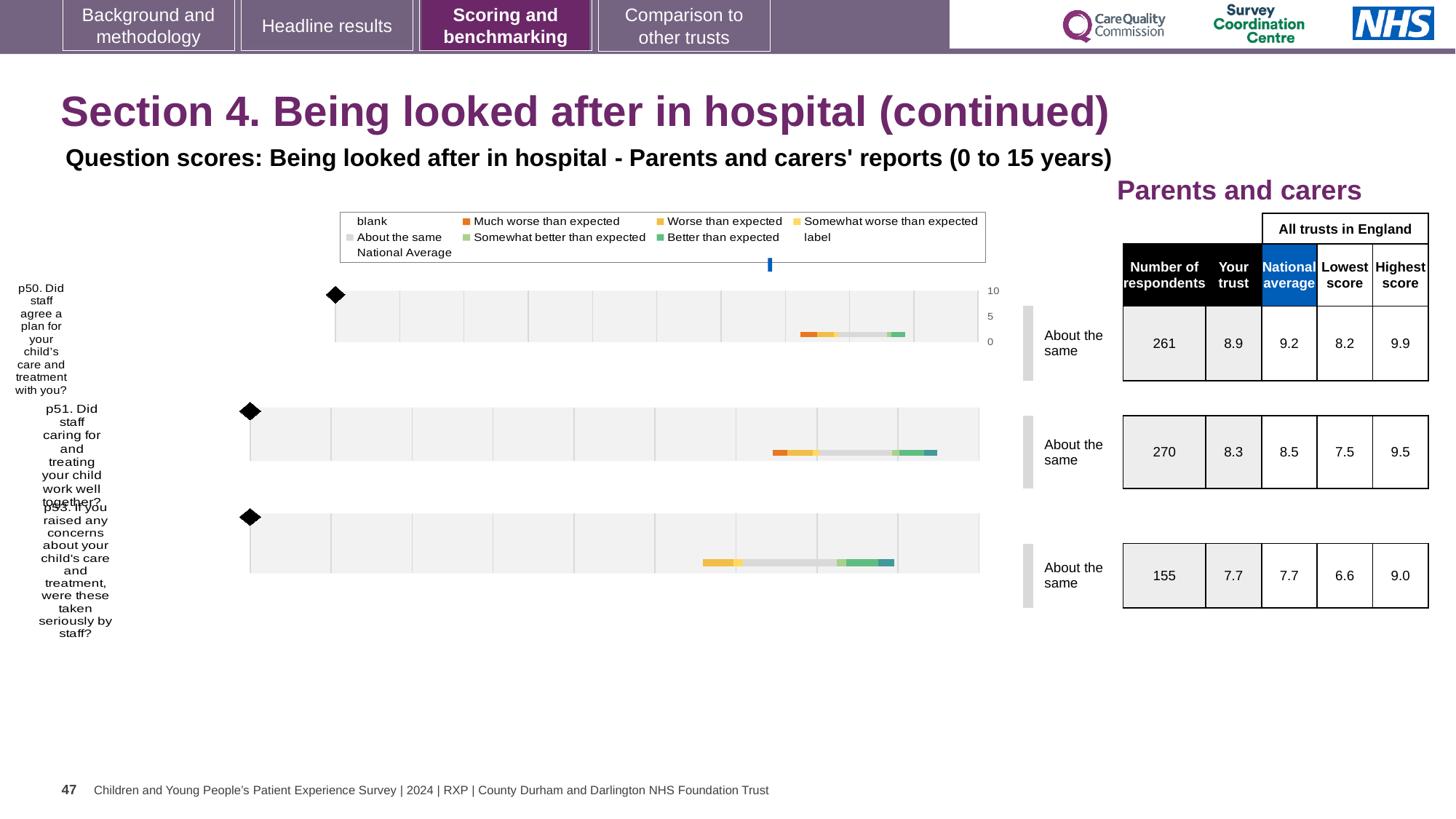
What kind of chart is used to show the question scores on this slide? bar chart How many questions (p50, p51, p53) are plotted as separate bars on the slide? 3 What is the difference between the National average and the 'Your trust' score for p50? 0.3 Which of the three questions has the highest 'Your trust' score in the table? p50 Which of the three questions has the lowest Number of respondents in the table? p53 In the table next to the charts, what is the 'Your trust' score for p50 (Did staff agree a plan for your child's care and treatment with you?)? 8.9 In the table next to the charts, what is the Number of respondents for p53 (If you raised any concerns about your child's care and treatment, were these taken seriously by staff?)? 155 What benchmark category is shown beside each of the three bars? About the same In the table next to the charts, what is the National average for p51 (Did staff caring for and treating your child work well together?)? 8.5 Is the 'Your trust' score for p51 larger or smaller than the National average for p51? smaller In the table next to the charts, what is the Lowest score for p53? 6.6 In the table next to the charts, what is the Highest score for p50? 9.9